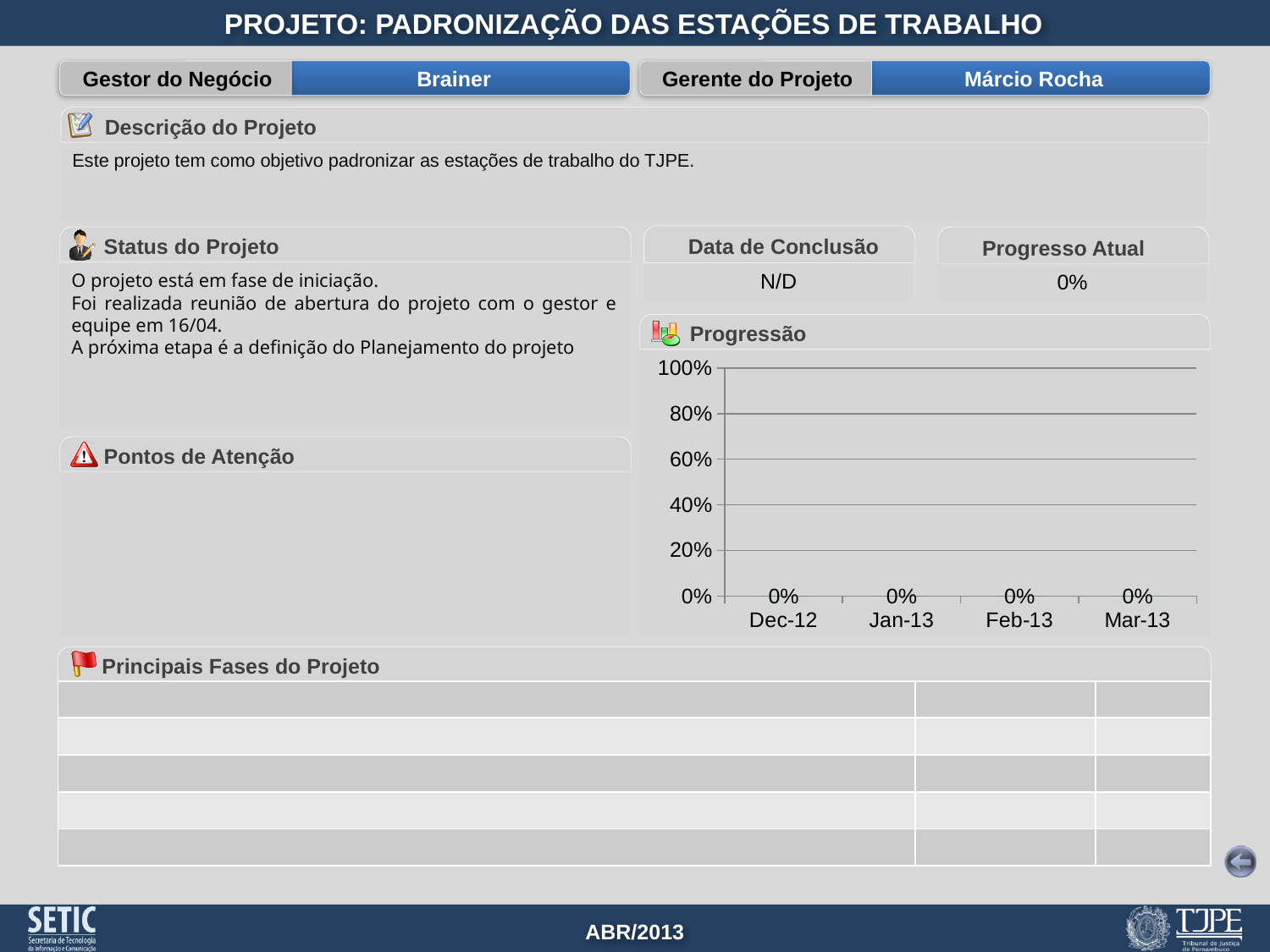
In the Progressão chart, is the value for Feb-13 greater or less than 20%? less What is the highest value shown on the y axis of the Progressão chart? 100% How many categories are shown on the x axis of the Progressão chart? 4 In the Progressão chart, what is the value for Jan-13? 0% What is the title of the chart on the slide? Progressão In the Progressão chart, what is the value for Mar-13? 0% Do the values in the Progressão chart rise, fall, or stay flat from Dec-12 to Mar-13? stay flat In the Progressão chart, is the value for Mar-13 greater or less than 40%? less What is the difference between the values for Mar-13 and Dec-12 in the Progressão chart? 0% Which is the first category on the x axis of the Progressão chart? Dec-12 In the Progressão chart, what is the value for Feb-13? 0% In the Progressão chart, what is the value for Dec-12? 0%